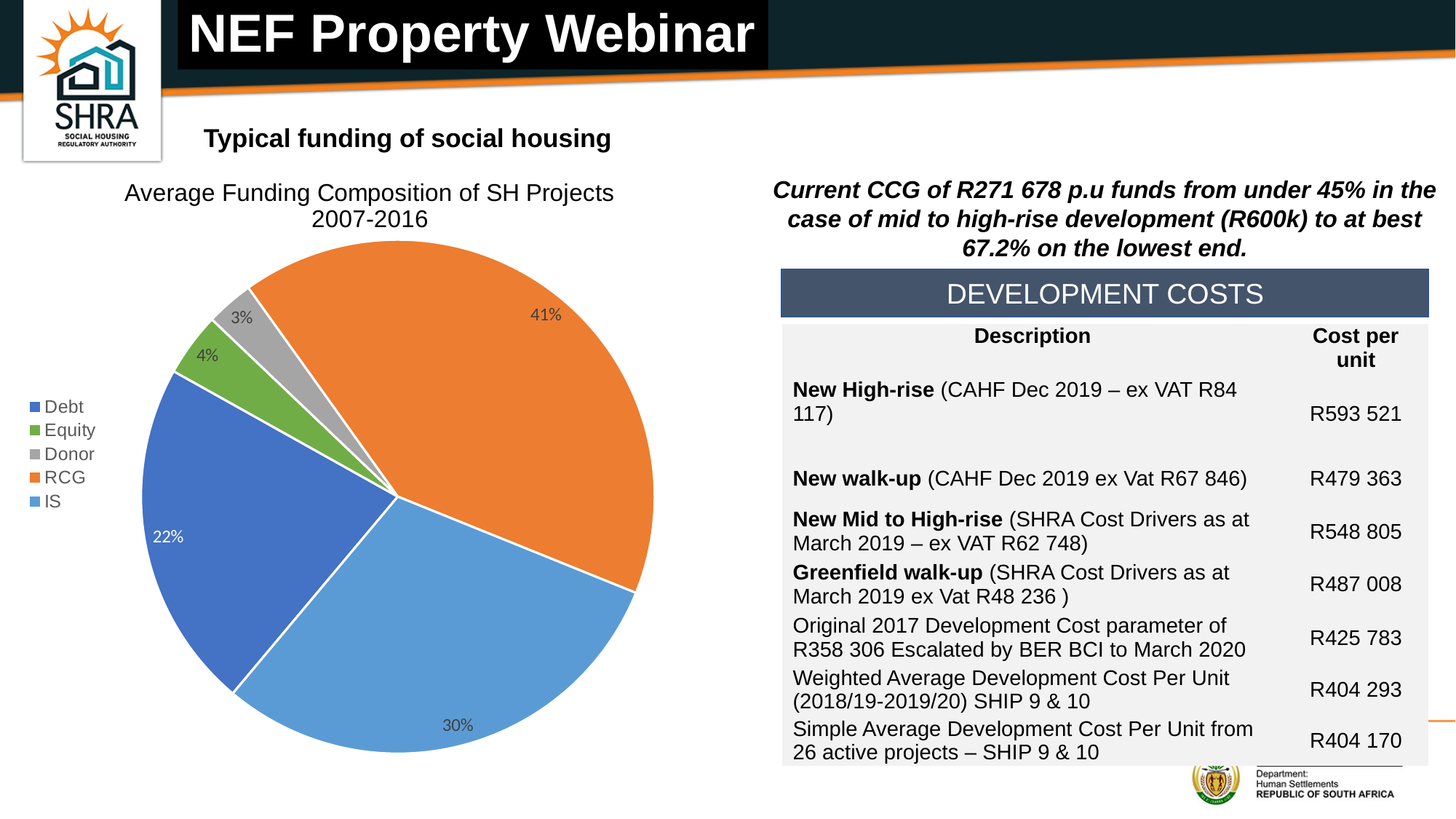
Which funding source has the largest share of the pie? RCG What share of the pie does Debt account for? 22% What share of the pie does RCG account for? 41% What is the difference in percentage points between the RCG share and the IS share? 11% What share of the pie does IS account for? 30% What is the title of the chart? Average Funding Composition of SH Projects 2007-2016 Which has a larger share, Debt or Equity? Debt How many categories does the pie chart show? 5 What type of chart is shown on the slide? pie chart Which funding source has the smallest share of the pie? Donor